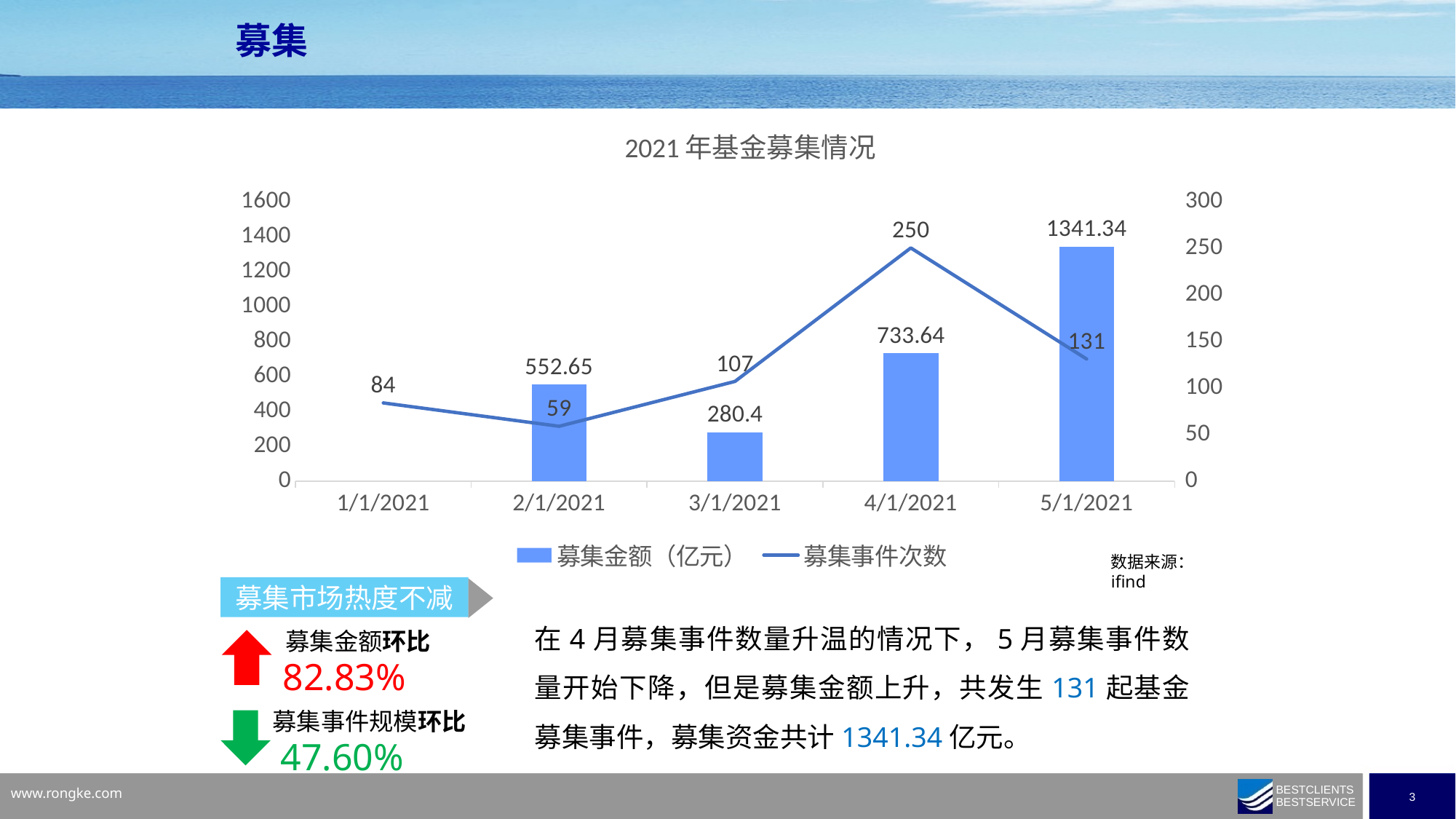
What is the 募集金额（亿元） value for 5/1/2021? 1341.34 What is the title of the chart? 2021年基金募集情况 How many series does the chart legend list? 2 Which month has the highest 募集事件次数? 4/1/2021 What is the 募集事件次数 value for 4/1/2021? 250 How many months are shown on the x axis of the chart? 5 Which month has the highest 募集金额（亿元）? 5/1/2021 What is the difference in 募集事件次数 between 4/1/2021 and 5/1/2021? 119 What is the 募集金额（亿元） value for 3/1/2021? 280.4 Which is larger, the 募集金额（亿元） for 2/1/2021 or for 4/1/2021? 4/1/2021 What is the 募集事件次数 value for 1/1/2021? 84 Which month has the lowest 募集事件次数? 2/1/2021